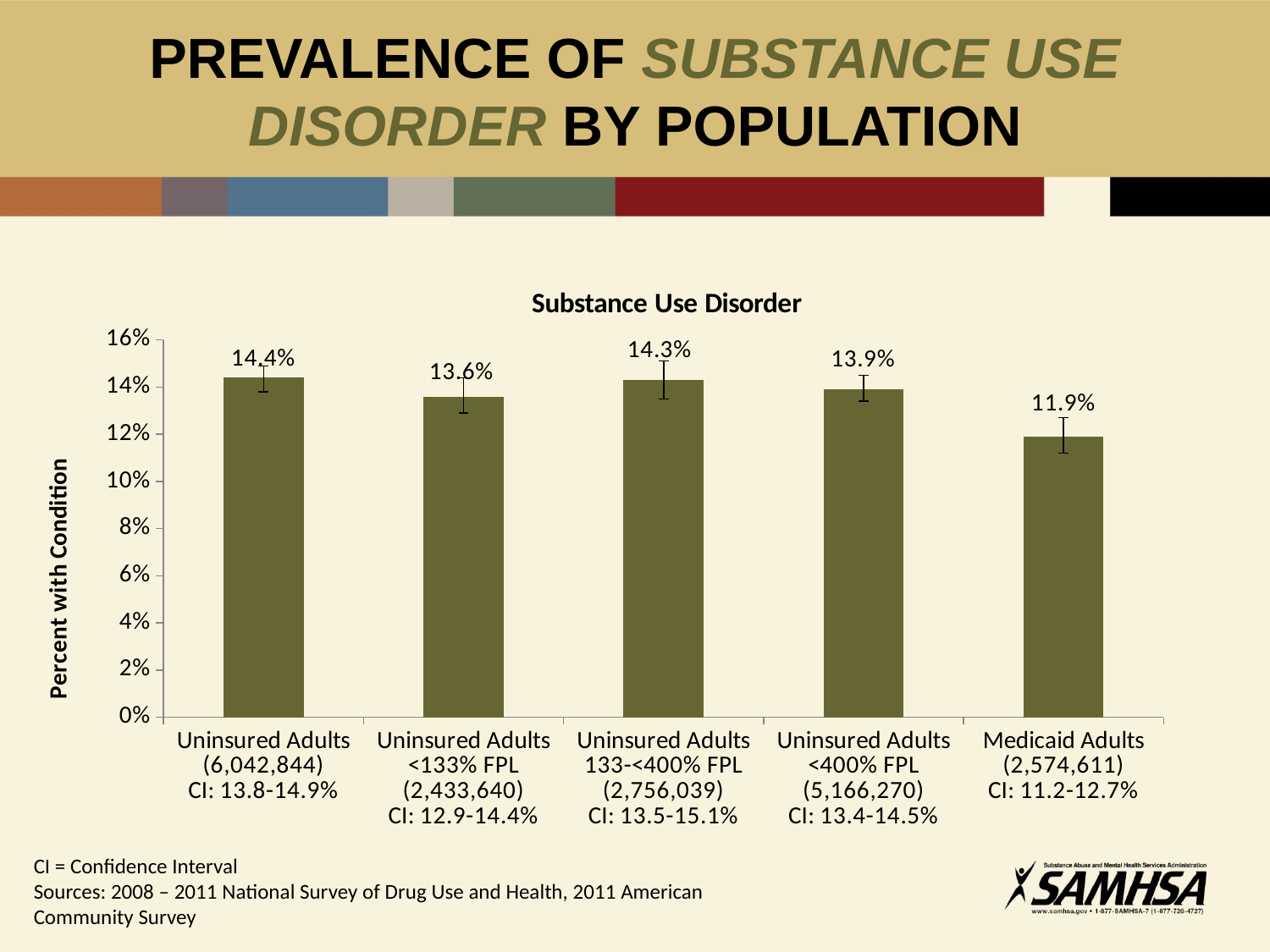
Is the value for Medicaid Adults greater or less than 12%? less Which is larger, the value for Uninsured Adults <400% FPL or the value for Medicaid Adults? Uninsured Adults <400% FPL What is the value for Uninsured Adults 133-<400% FPL? 14.3% What is the difference between the values for Uninsured Adults (6,042,844) and Medicaid Adults? 2.5% What kind of chart is shown? bar chart What is the value for Medicaid Adults? 11.9% What is the difference between the values for Uninsured Adults <400% FPL and Uninsured Adults <133% FPL? 0.3% What is the value for Uninsured Adults <133% FPL? 13.6% Which category has the lowest value? Medicaid Adults What is the title of the chart? Substance Use Disorder What is the value for Uninsured Adults (6,042,844)? 14.4% How many categories are shown on the chart? 5